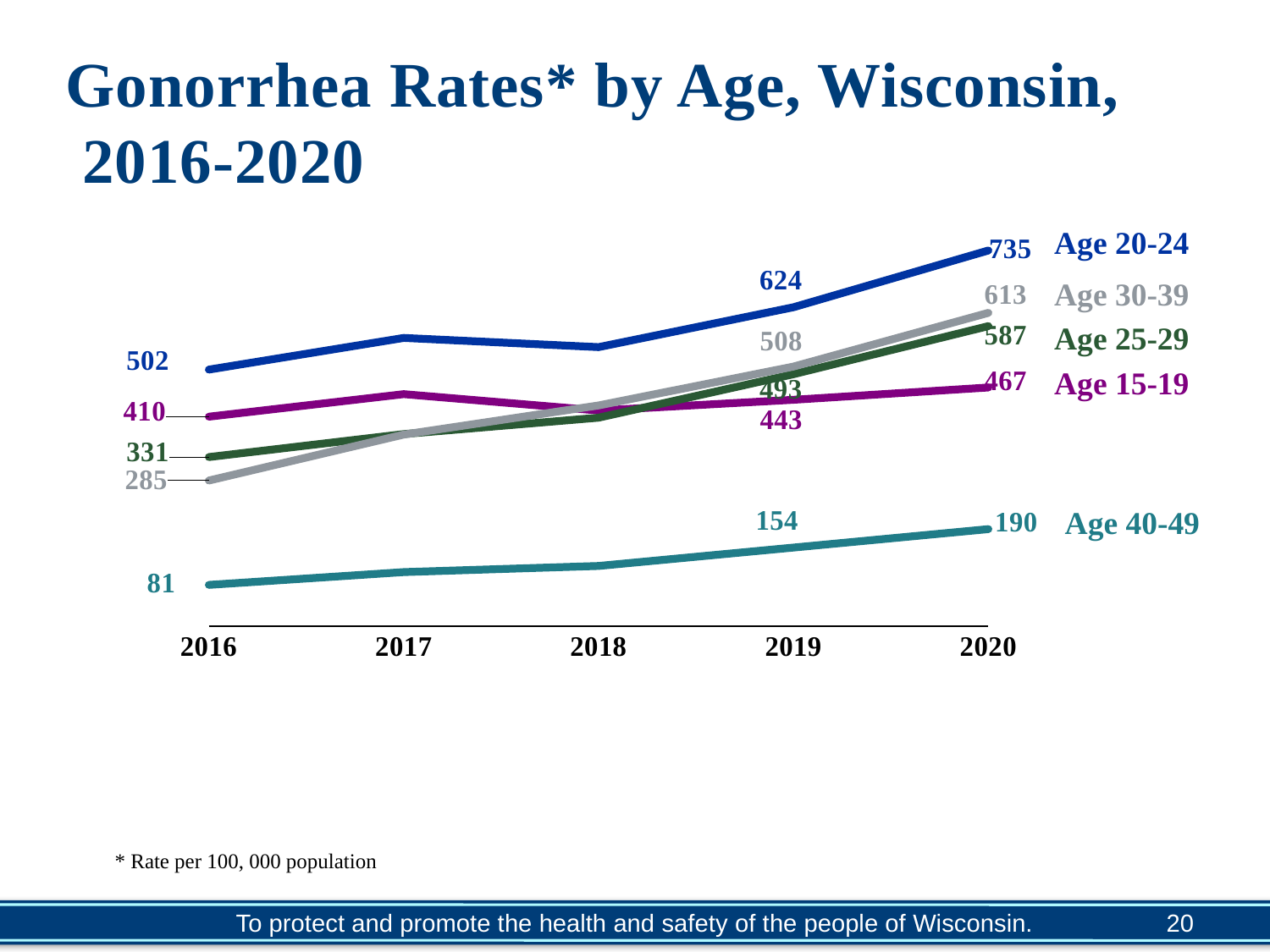
How many years are shown on the x axis? 5 What was the gonorrhea rate for Age 40-49 in 2016? 81 How many age groups are plotted on the chart? 5 What was the gonorrhea rate for Age 15-19 in 2016? 410 What was the gonorrhea rate for Age 30-39 in 2019? 508 What kind of chart is shown on the slide? Line chart What was the gonorrhea rate for Age 20-24 in 2020? 735 Which age group had the highest gonorrhea rate in 2020? Age 20-24 What is the difference between the 2020 rates for Age 30-39 and Age 25-29? 26 By how much did the gonorrhea rate for Age 20-24 increase from 2016 to 2020? 233 In 2019, which had the higher gonorrhea rate: Age 25-29 or Age 15-19? Age 25-29 Which age group had the lowest gonorrhea rate in 2016? Age 40-49